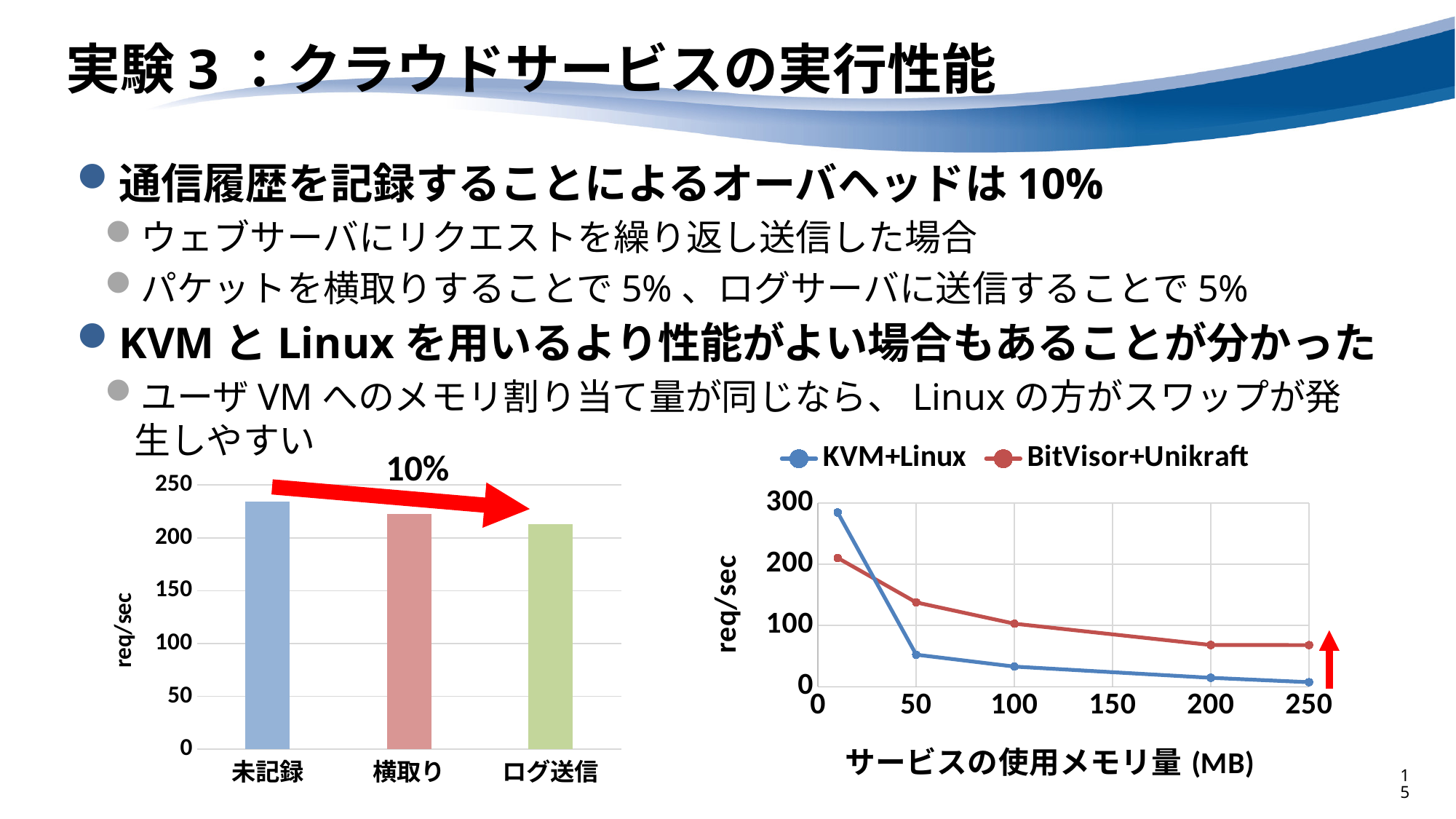
In the right line chart, how many series does the legend list? 2 In the right line chart, do the values for KVM+Linux rise or fall as memory increases along the x axis? fall In the left bar chart, what is the label of the y axis? req/sec In the left bar chart, which category has the highest value? 未記録 What kind of chart is the chart on the right of the slide? line chart In the left bar chart, how many categories are shown on the x axis? 3 What kind of chart is the chart on the left of the slide? bar chart In the left bar chart, is the value for ログ送信 greater or less than 250? less In the right line chart, is the value for KVM+Linux at 50 MB greater or less than 100? less In the right line chart, which series has the higher value at 250 MB, KVM+Linux or BitVisor+Unikraft? BitVisor+Unikraft In the left bar chart, is the value for 未記録 greater or less than 200? greater In the left bar chart, which category has the lowest value? ログ送信